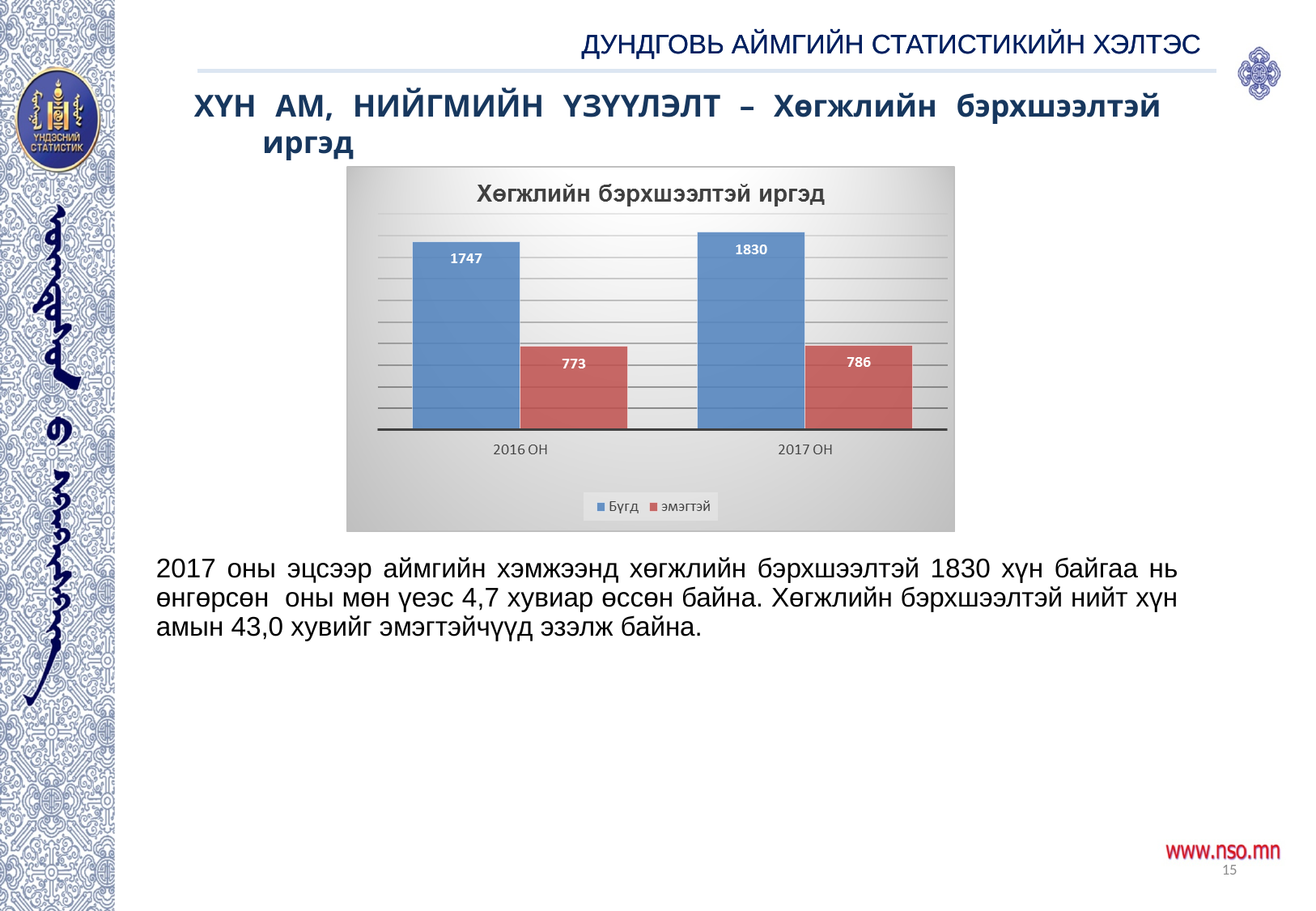
How many series does the legend list? 2 What is the value of Бүгд for 2016 ОН? 1747 Which year has the higher value for Бүгд? 2017 ОН What kind of chart is shown? Bar chart What is the value of эмэгтэй for 2017 ОН? 786 What is the title of the chart? Хөгжлийн бэрхшээлтэй иргэд What is the difference between the Бүгд values for 2017 ОН and 2016 ОН? 83 Which is larger: Бүгд for 2016 ОН or эмэгтэй for 2017 ОН? Бүгд for 2016 ОН What is the difference between the эмэгтэй values for 2017 ОН and 2016 ОН? 13 What is the value of Бүгд for 2017 ОН? 1830 How many categories are shown on the x axis? 2 What is the value of эмэгтэй for 2016 ОН? 773